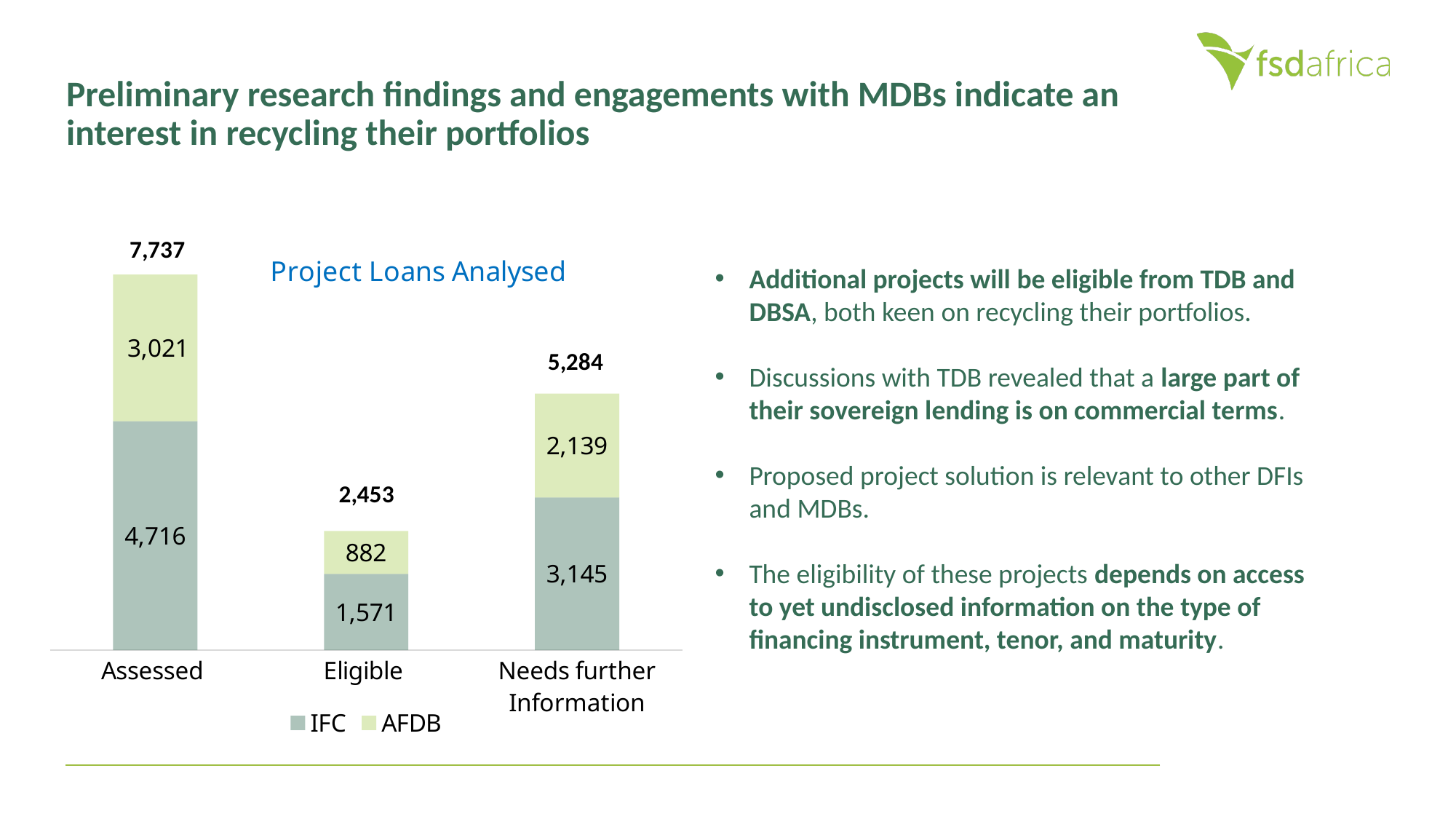
What is the AFDB value for the Eligible category? 882 What is the total of the stacked bar for Needs further Information? 5,284 How many series does the legend list? 2 What is the total of the stacked bar for Eligible? 2,453 Which is larger, the AFDB value for Needs further Information or the AFDB value for Eligible? Needs further Information Which category has the highest total? Assessed What is the difference between the IFC and AFDB values for the Assessed category? 1,695 What is the IFC value for the Needs further Information category? 3,145 What is the IFC value for the Assessed category? 4,716 What is the title of the chart? Project Loans Analysed How many categories are shown on the x axis? 3 Which category has the lowest total? Eligible